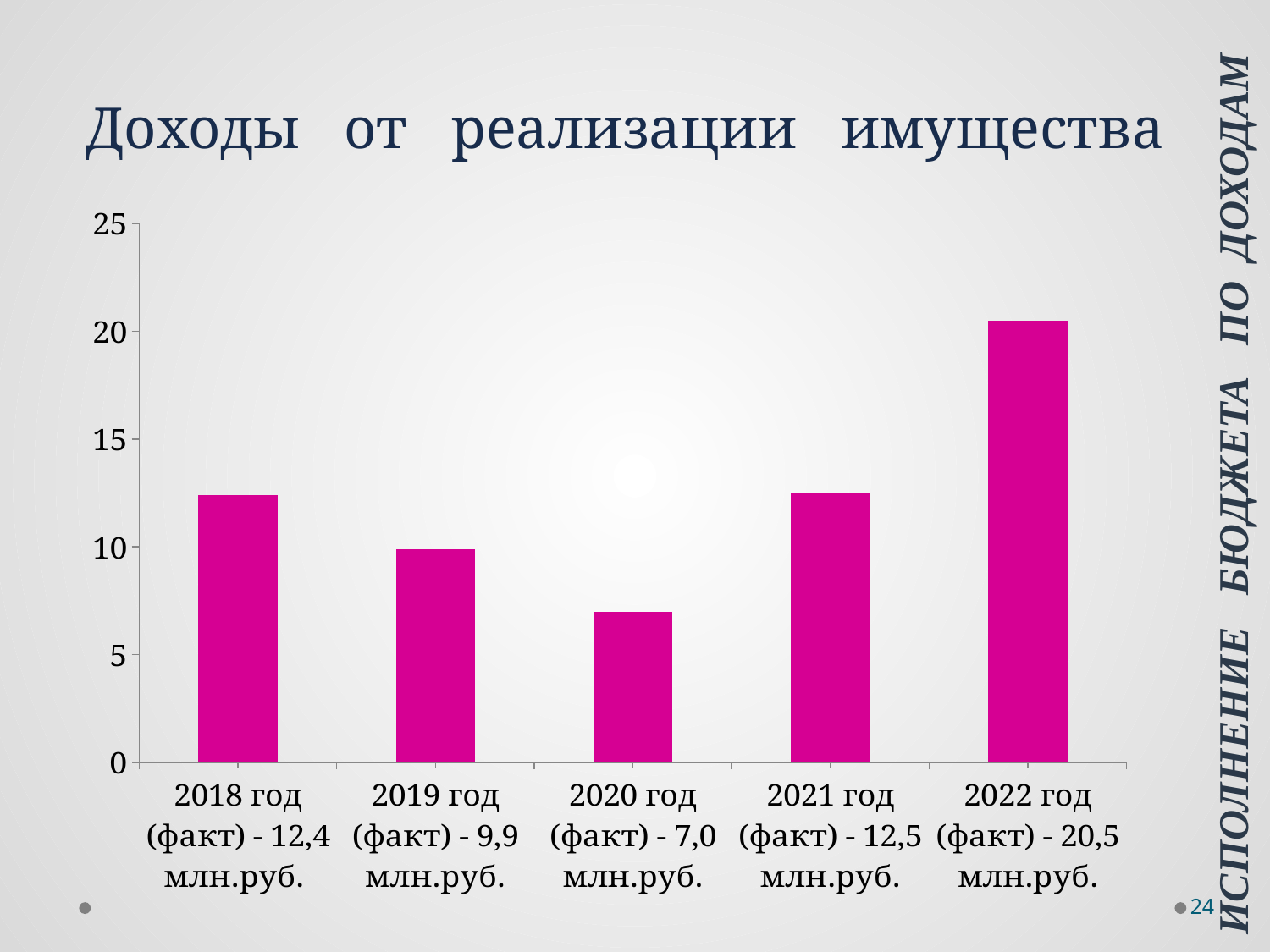
What is the value for 2019 год (факт)? 9,9 млн.руб. What type of chart is shown on the slide? bar chart Do the values rise or fall from 2020 год to 2022 год? rise Is the value for 2022 год greater or less than 20? greater How many years (categories) are shown in the chart? 5 Which is larger, the value for 2019 год or the value for 2020 год? 2019 год What is the title of the chart? Доходы от реализации имущества What is the difference between the values for 2022 год and 2021 год? 8,0 млн.руб. Which year has the highest value? 2022 год What is the value for 2020 год (факт)? 7,0 млн.руб. Which year has the lowest value? 2020 год What is the value for 2022 год (факт)? 20,5 млн.руб.